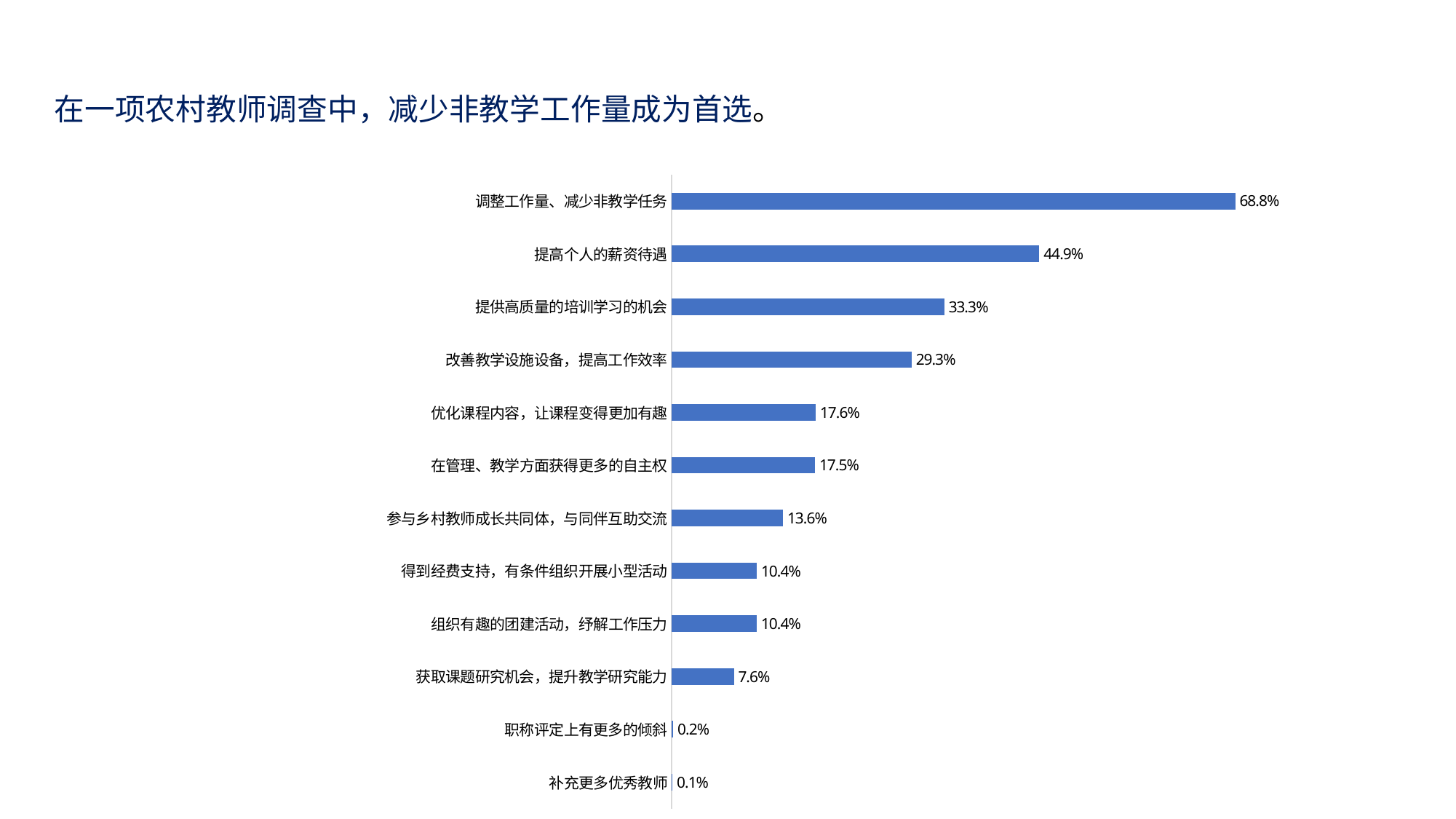
What is the value for 补充更多优秀教师? 0.1% How many categories are shown in the chart? 12 Which is larger, the value for 提供高质量的培训学习的机会 or the value for 改善教学设施设备，提高工作效率? 提供高质量的培训学习的机会 What is the difference between the values for 提供高质量的培训学习的机会 and 改善教学设施设备，提高工作效率? 4.0% What is the difference between the values for 调整工作量、减少非教学任务 and 提高个人的薪资待遇? 23.9% What is the title text at the top of the slide? 在一项农村教师调查中，减少非教学工作量成为首选。 Which category has the highest value? 调整工作量、减少非教学任务 What is the value for 参与乡村教师成长共同体，与同伴互助交流? 13.6% What kind of chart is shown on the slide? Bar chart What is the value for 调整工作量、减少非教学任务? 68.8% What is the value for 提高个人的薪资待遇? 44.9% Which category has the lowest value? 补充更多优秀教师